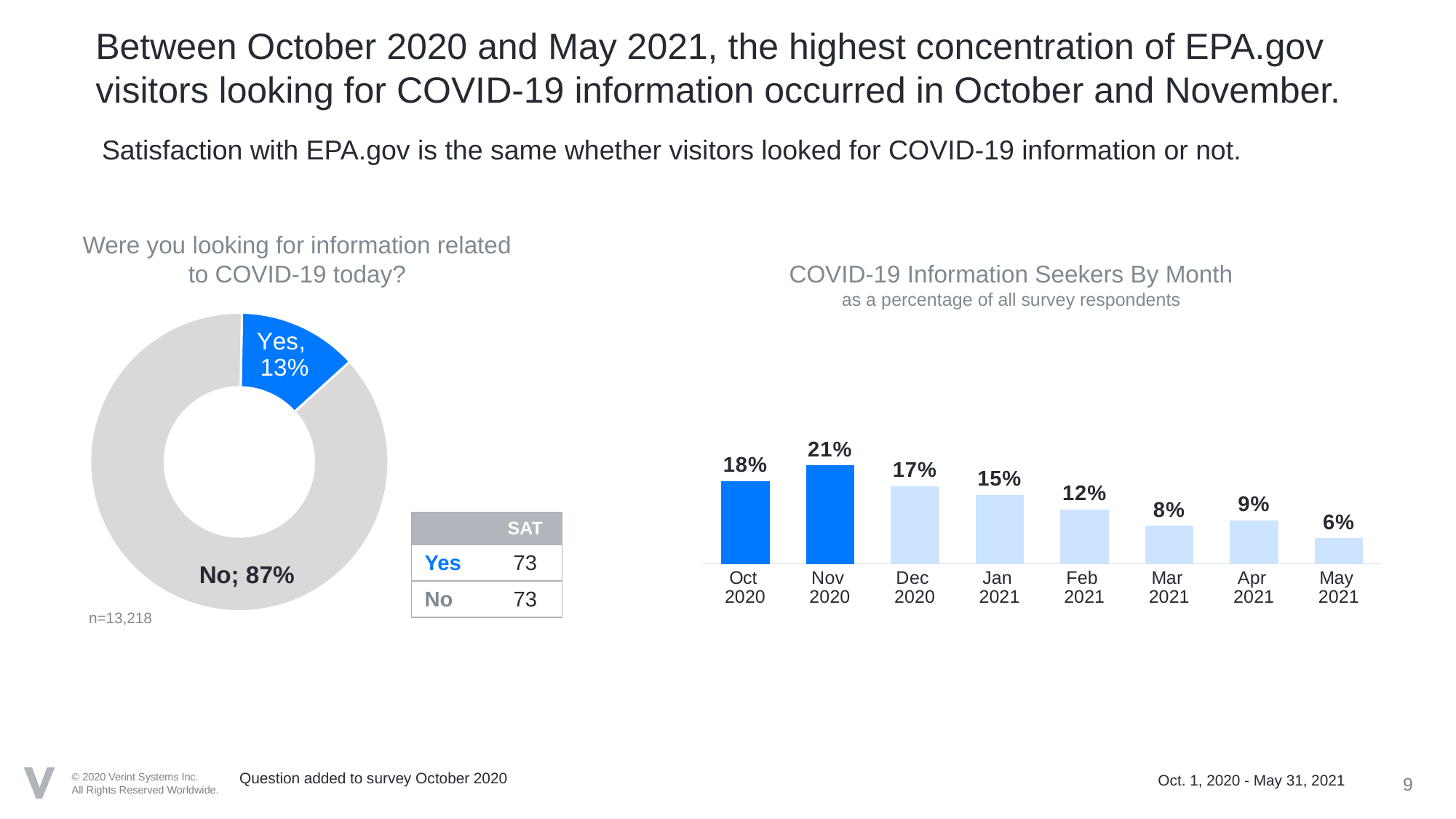
What kind of chart is 'Were you looking for information related to COVID-19 today?'? Doughnut chart What kind of chart is 'COVID-19 Information Seekers By Month'? Bar chart In the 'COVID-19 Information Seekers By Month' chart, what is the value for Feb 2021? 12% In the 'COVID-19 Information Seekers By Month' chart, which month has the highest value? Nov 2020 In the 'COVID-19 Information Seekers By Month' chart, do the values generally rise or fall from Nov 2020 to May 2021? Fall In the 'Were you looking for information related to COVID-19 today?' chart, what share of respondents answered No? 87% In the 'Were you looking for information related to COVID-19 today?' chart, what share of respondents answered Yes? 13% In the 'COVID-19 Information Seekers By Month' chart, which month has the lowest value? May 2021 How many months are shown in the 'COVID-19 Information Seekers By Month' chart? 8 In the 'COVID-19 Information Seekers By Month' chart, what is the difference between the values for Nov 2020 and May 2021? 15% In the 'COVID-19 Information Seekers By Month' chart, what is the value for Nov 2020? 21% In the 'COVID-19 Information Seekers By Month' chart, which is larger, the value for Mar 2021 or Apr 2021? Apr 2021